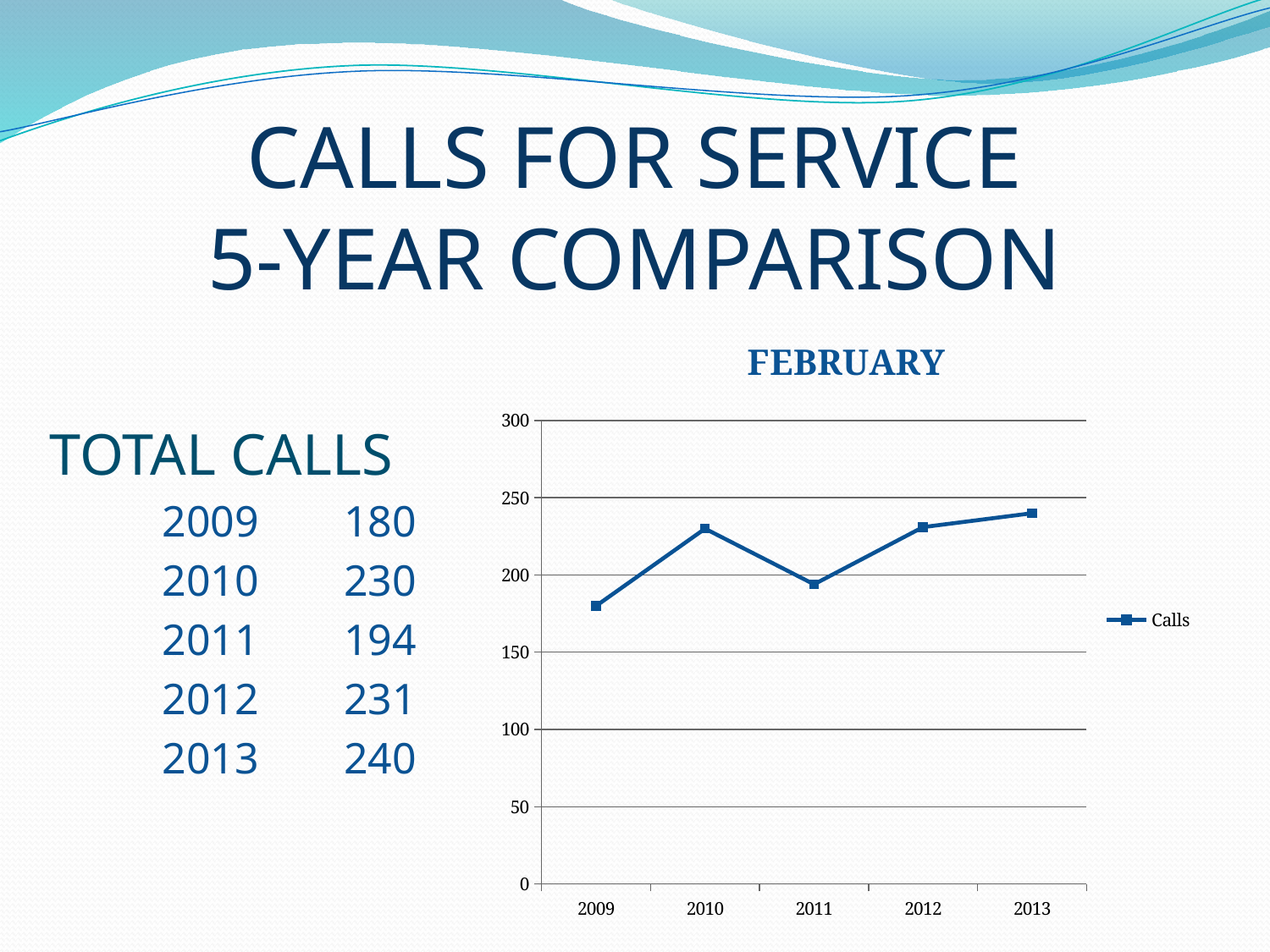
Which year has the lowest number of calls? 2009 What type of chart is shown on the slide? line chart What is the number of calls for 2011? 194 What is the number of calls for 2009? 180 What is the number of calls for 2013? 240 How many series does the chart legend list? 1 What is the difference in calls between 2013 and 2009? 60 Which year has more calls, 2011 or 2013? 2013 What is the title of the chart? FEBRUARY How many years are plotted on the x axis of the chart? 5 Which year has the highest number of calls? 2013 Is the value for 2009 greater or less than 200? less